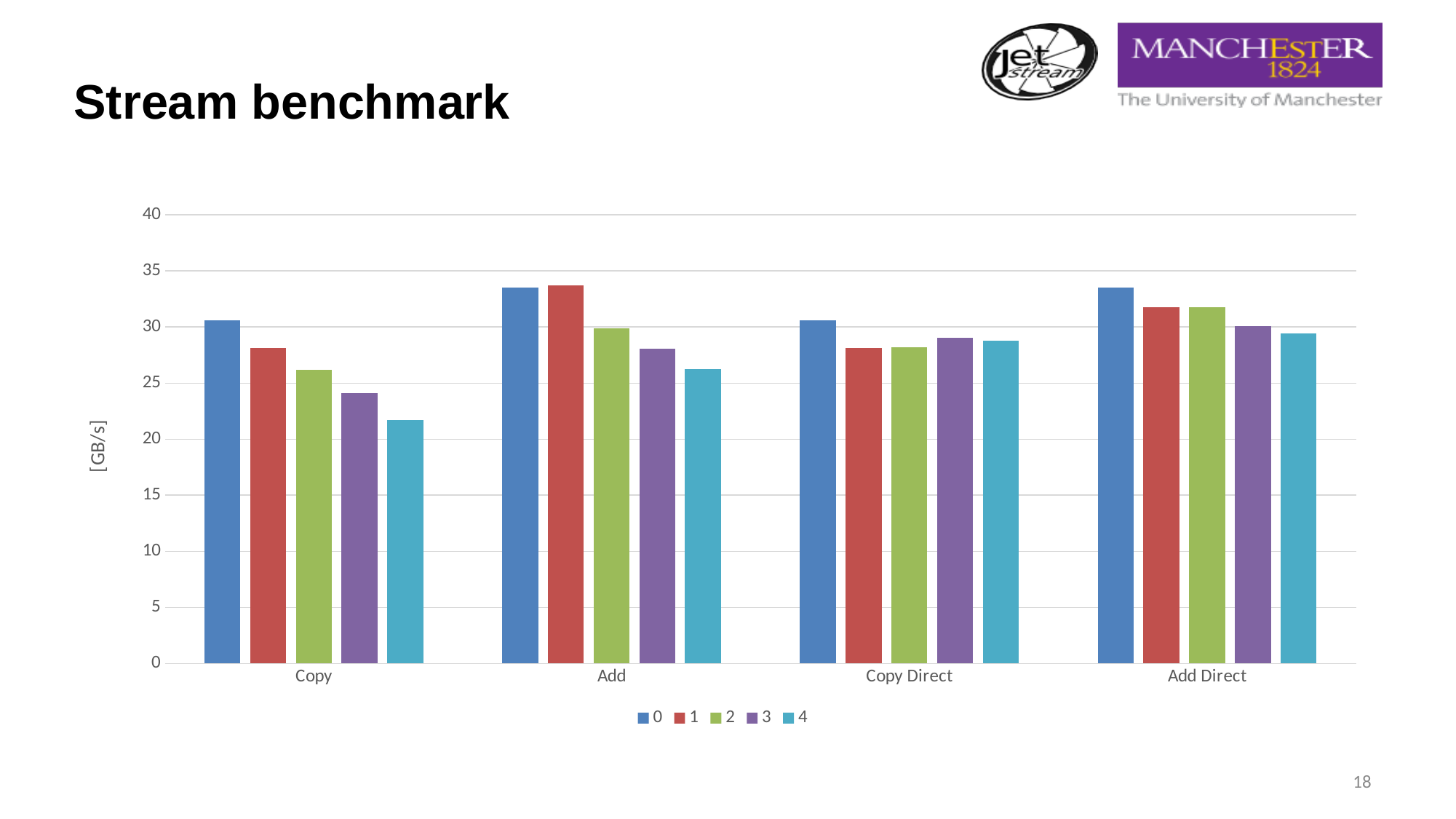
For series 2, which category has the larger value: Copy or Add? Add What is the label on the y axis of the chart? [GB/s] What is the title of the slide containing the chart? Stream benchmark Is the value for series 0 in the Add category greater or less than 30? greater Is the value for series 4 in the Copy category greater or less than 25? less What kind of chart is shown on the slide? bar chart Is the value for series 1 in the Copy Direct category greater or less than 30? less How many series does the legend list? 5 In the Copy category, which is larger: the value for series 0 or the value for series 4? series 0 How many categories are shown on the x axis of the chart? 4 Within the Copy category, do the values rise or fall from series 0 to series 4? fall Within the Copy category, which series has the lowest value? 4